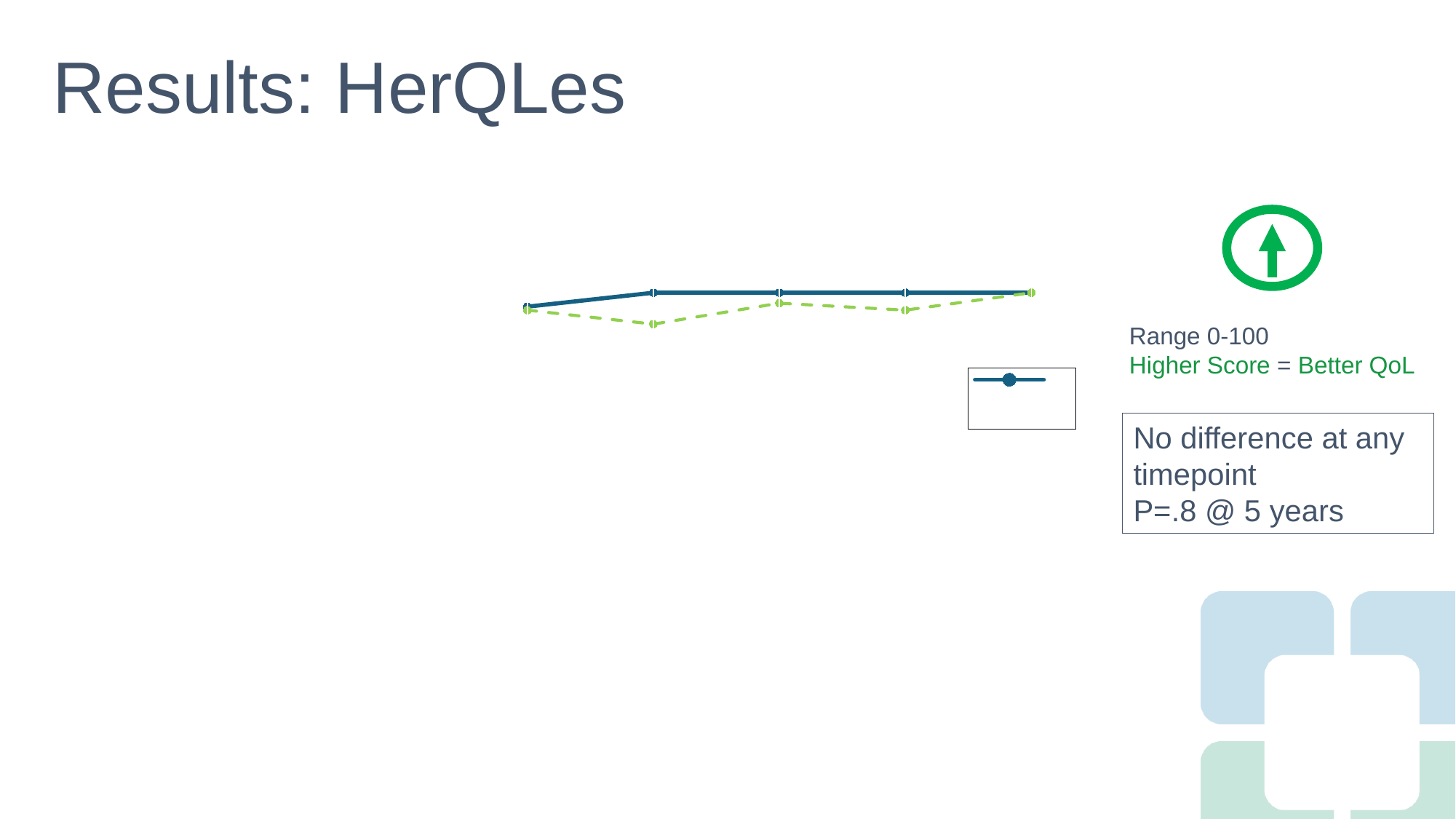
Does the solid line rise or fall between its first and second points? rise What colour is the dashed line on the chart? green How many data points does the dashed line have? 5 How many lines are plotted on the chart? 2 How many data points does the solid line have? 5 Does the dashed line rise or fall between its second and third points? rise Does the dashed line rise or fall between its first and second points? fall At the fourth data point, which line is higher, the solid line or the dashed line? the solid line At the second data point, which line is higher, the solid line or the dashed line? the solid line What kind of chart is shown on the slide? line chart What colour is the solid line on the chart? blue